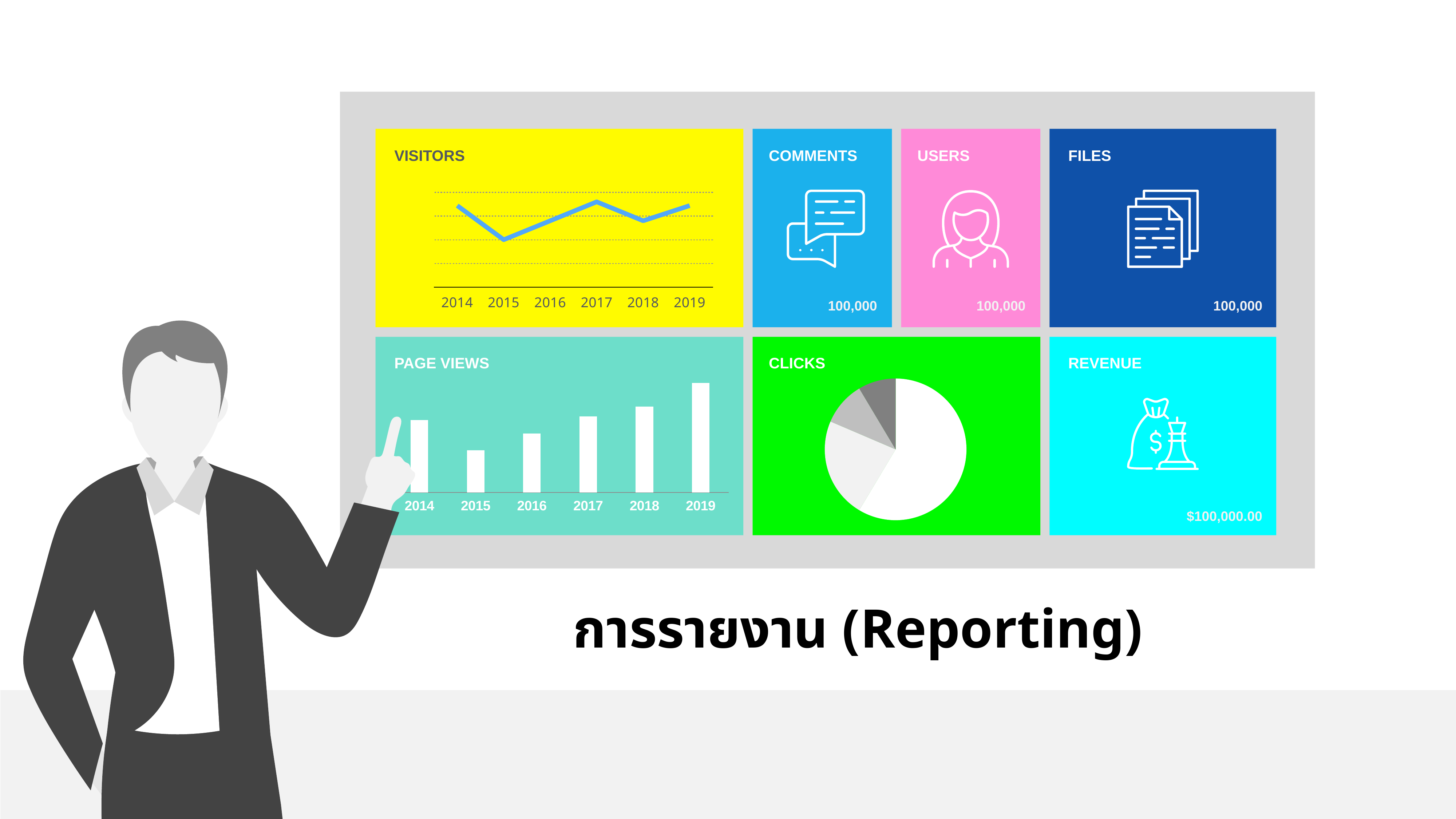
What kind of chart is the VISITORS chart? line chart In the PAGE VIEWS chart, which year has the tallest bar? 2019 How many slices does the CLICKS pie chart have? 4 How many points are plotted on the VISITORS line chart? 6 What kind of chart is the PAGE VIEWS chart? bar chart What kind of chart is the CLICKS chart? pie chart In the PAGE VIEWS chart, do the bars generally rise or fall from 2015 to 2019? rise In the VISITORS chart, which year has the lowest point on the line? 2015 How many years are shown on the x axis of the PAGE VIEWS chart? 6 In the PAGE VIEWS chart, is the bar for 2018 taller or shorter than the bar for 2016? taller In the VISITORS chart, is the value for 2014 higher or lower than the value for 2015? higher In the PAGE VIEWS chart, which year has the shortest bar? 2015